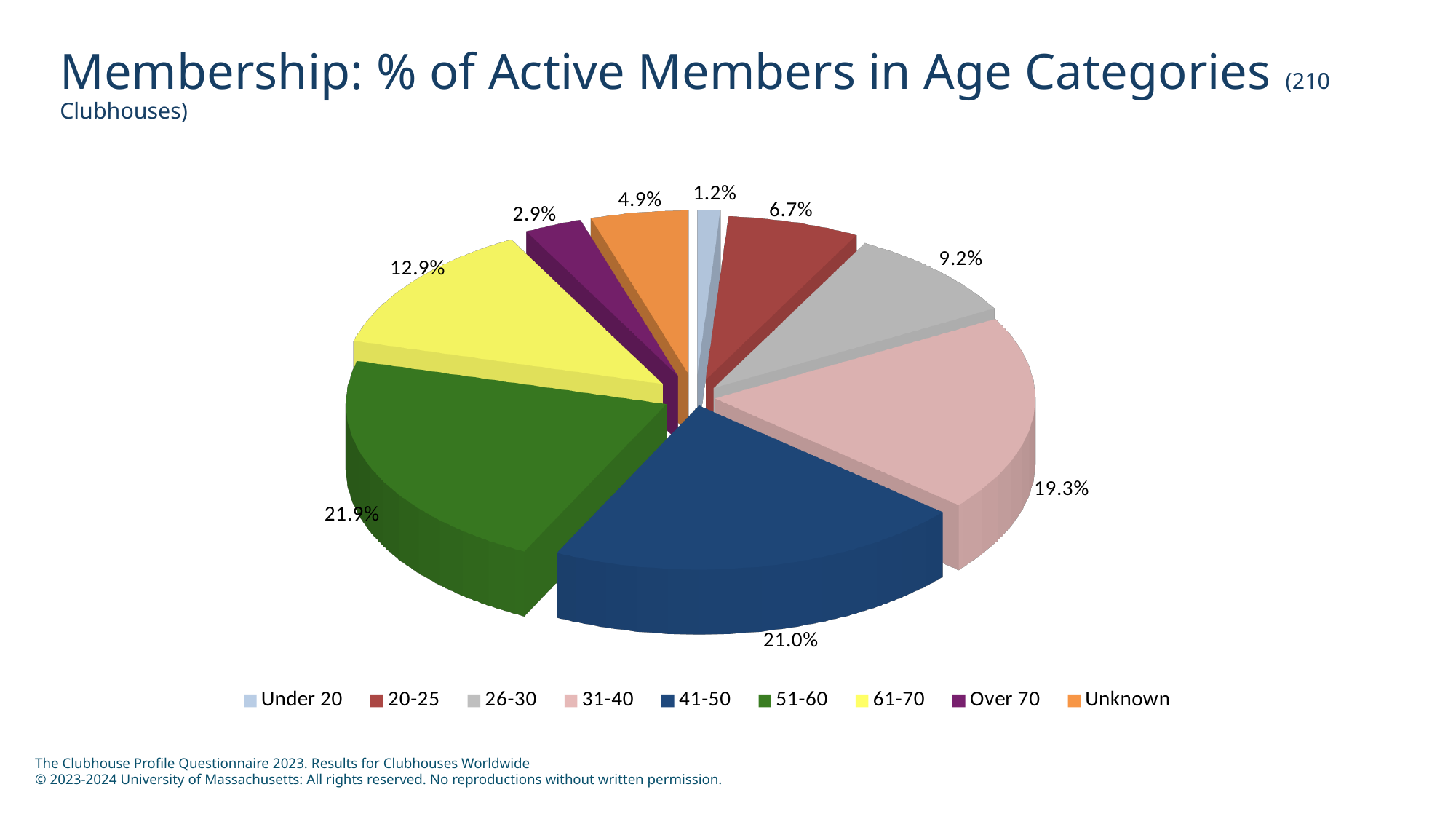
What colour represents the 41-50 age category in the pie chart? Dark blue What percentage of active members are of Unknown age? 4.9% Which age category has the largest share of active members? 51-60 How many age categories are shown in the pie chart? 9 What percentage of active members are in the 31-40 age category? 19.3% What is the combined share of the 41-50 and 51-60 age categories? 42.9% What type of chart is shown on the slide? Pie chart Which has a larger share of active members, the 26-30 category or the 20-25 category? 26-30 What is the difference in percentage points between the 51-60 and 41-50 age categories? 0.9 Which age category has the smallest share of active members? Under 20 What percentage of active members are Over 70? 2.9% What percentage of active members are in the 61-70 age category? 12.9%